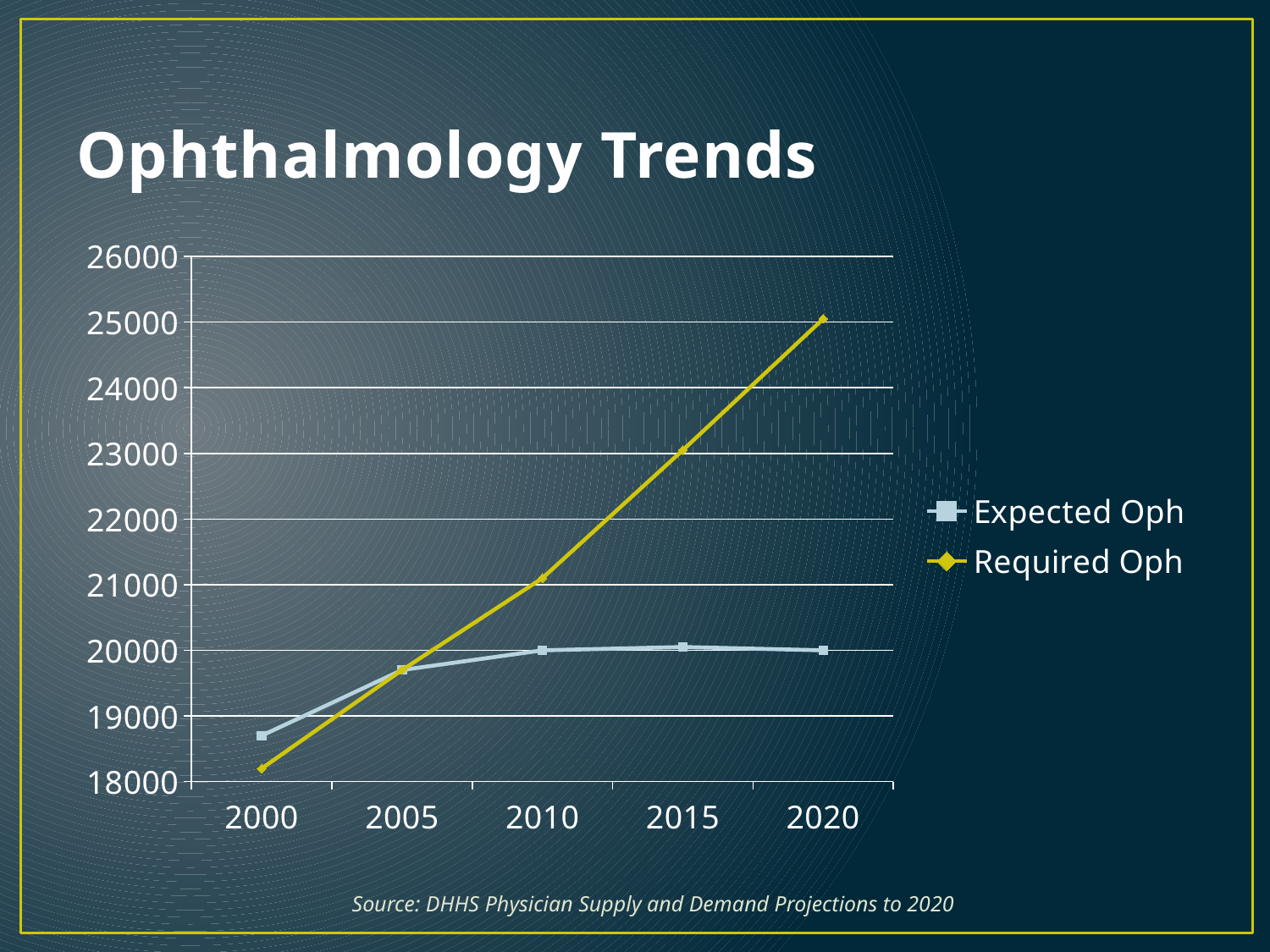
Is the value for Expected Oph in 2000 greater or less than 19000? less Is the value for Expected Oph in 2020 greater or less than 21000? less Is the value for Required Oph in 2015 greater or less than 22000? greater How many years are plotted along the x axis? 5 Which series is drawn in yellow? Required Oph In 2000, which series has the higher value, Expected Oph or Required Oph? Expected Oph Does the Required Oph series rise or fall from 2000 to 2020? rise What kind of chart is shown on the slide? Line chart What is the title of the chart? Ophthalmology Trends In 2020, which series has the higher value, Expected Oph or Required Oph? Required Oph How many series does the legend list? 2